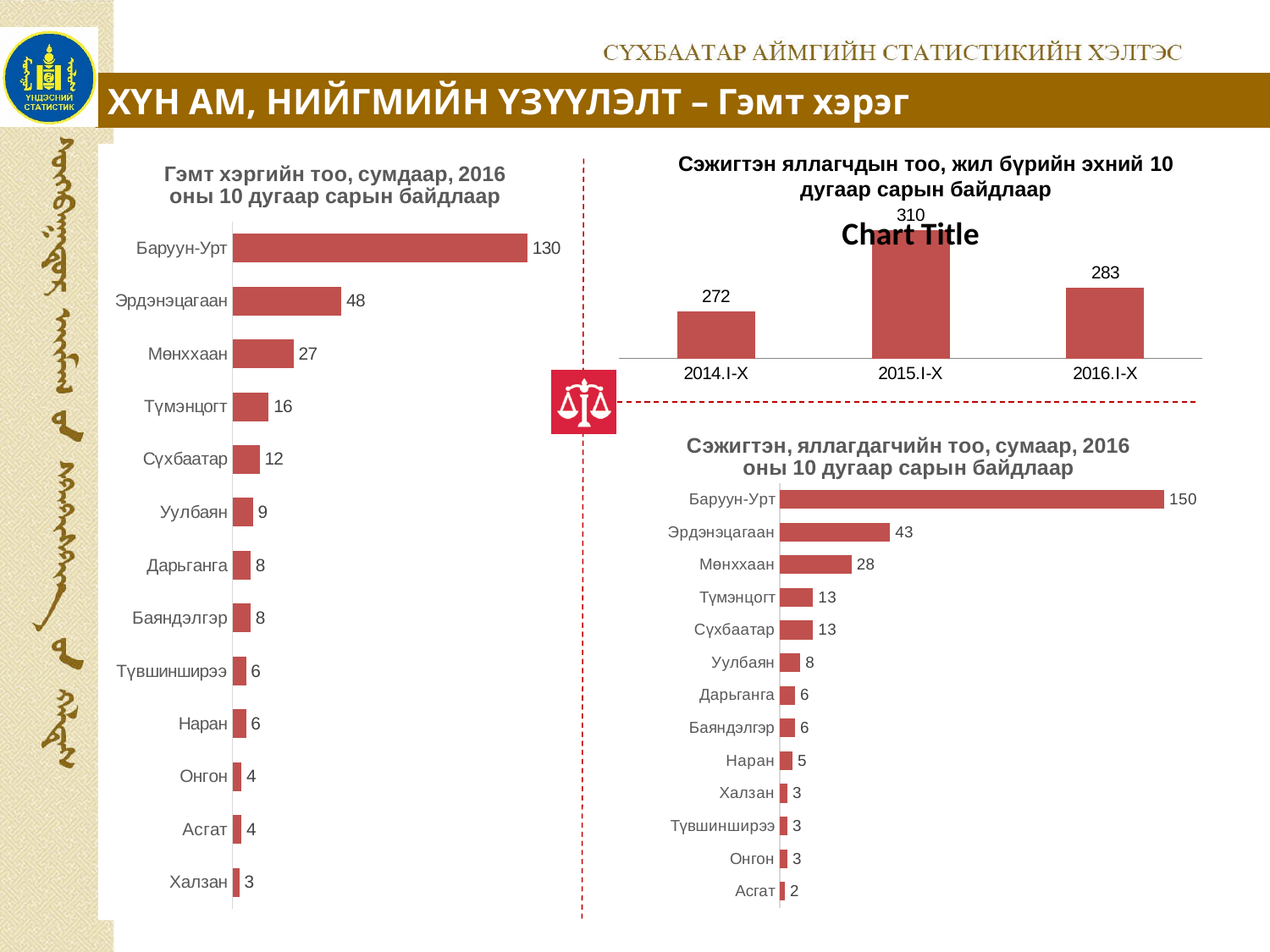
In the left chart 'Гэмт хэргийн тоо, сумдаар', how many categories are shown? 13 In the top-right chart 'Сэжигтэн яллагчдын тоо', what is the difference between the values for 2015.I-X and 2014.I-X? 38 In the bottom-right chart 'Сэжигтэн, яллагдагчийн тоо, сумаар', what is the value for Мөнххаан? 28 In the bottom-right chart 'Сэжигтэн, яллагдагчийн тоо, сумаар', which category has the lowest value? Асгат In the left chart 'Гэмт хэргийн тоо, сумдаар, 2016 оны 10 дугаар сарын байдлаар', what is the value for Баруун-Урт? 130 In the left chart 'Гэмт хэргийн тоо, сумдаар', which category has the lowest value? Халзан In the left chart 'Гэмт хэргийн тоо, сумдаар', what is the difference between the values for Баруун-Урт and Эрдэнэцагаан? 82 In the bottom-right chart 'Сэжигтэн, яллагдагчийн тоо, сумаар, 2016 оны 10 дугаар сарын байдлаар', what is the value for Баруун-Урт? 150 In the top-right chart 'Сэжигтэн яллагчдын тоо, жил бүрийн эхний 10 дугаар сарын байдлаар', what is the value for 2015.I-X? 310 In the top-right chart 'Сэжигтэн яллагчдын тоо', which period has the highest value? 2015.I-X In the left chart 'Гэмт хэргийн тоо, сумдаар', which is larger, the value for Мөнххаан or the value for Түмэнцогт? Мөнххаан What kind of chart is the top-right chart 'Сэжигтэн яллагчдын тоо'? Bar chart